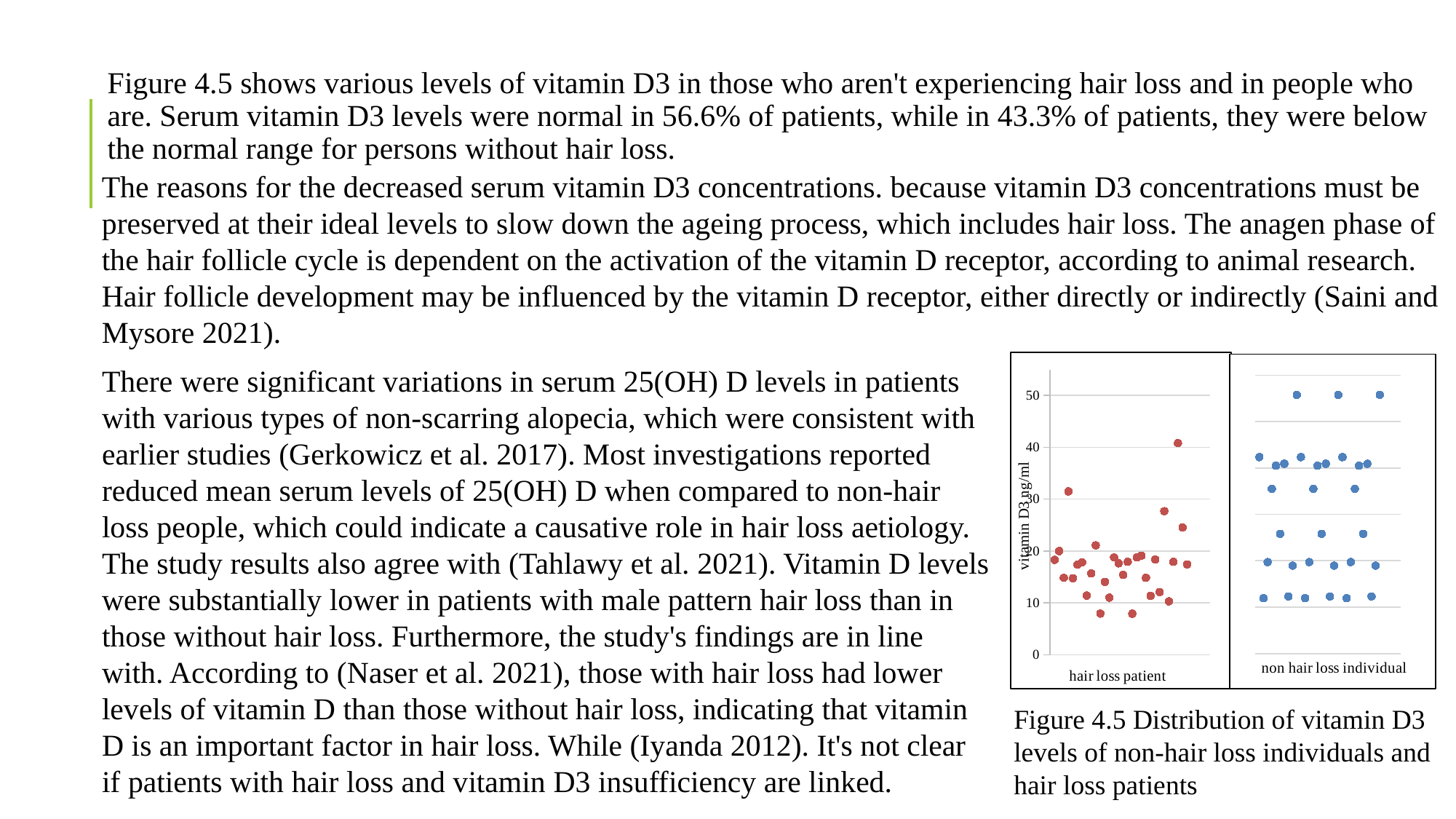
In Figure 4.5, is the lowest vitamin D3 value among non hair loss individuals greater or less than 20? less How many groups are plotted in the chart in Figure 4.5? 2 In Figure 4.5, what colour are the points for hair loss patients? red What kind of chart is shown in Figure 4.5? scatter chart What is the label on the vertical axis of the chart in Figure 4.5? vitamin D3 ng/ml In Figure 4.5, are most of the hair loss patient values greater or less than 20? less In Figure 4.5, which group has the higher maximum vitamin D3 value, hair loss patients or non hair loss individuals? non hair loss individual In Figure 4.5, which group has the lower minimum vitamin D3 value, hair loss patients or non hair loss individuals? hair loss patient In Figure 4.5, is the highest vitamin D3 value among non hair loss individuals greater or less than 40? greater